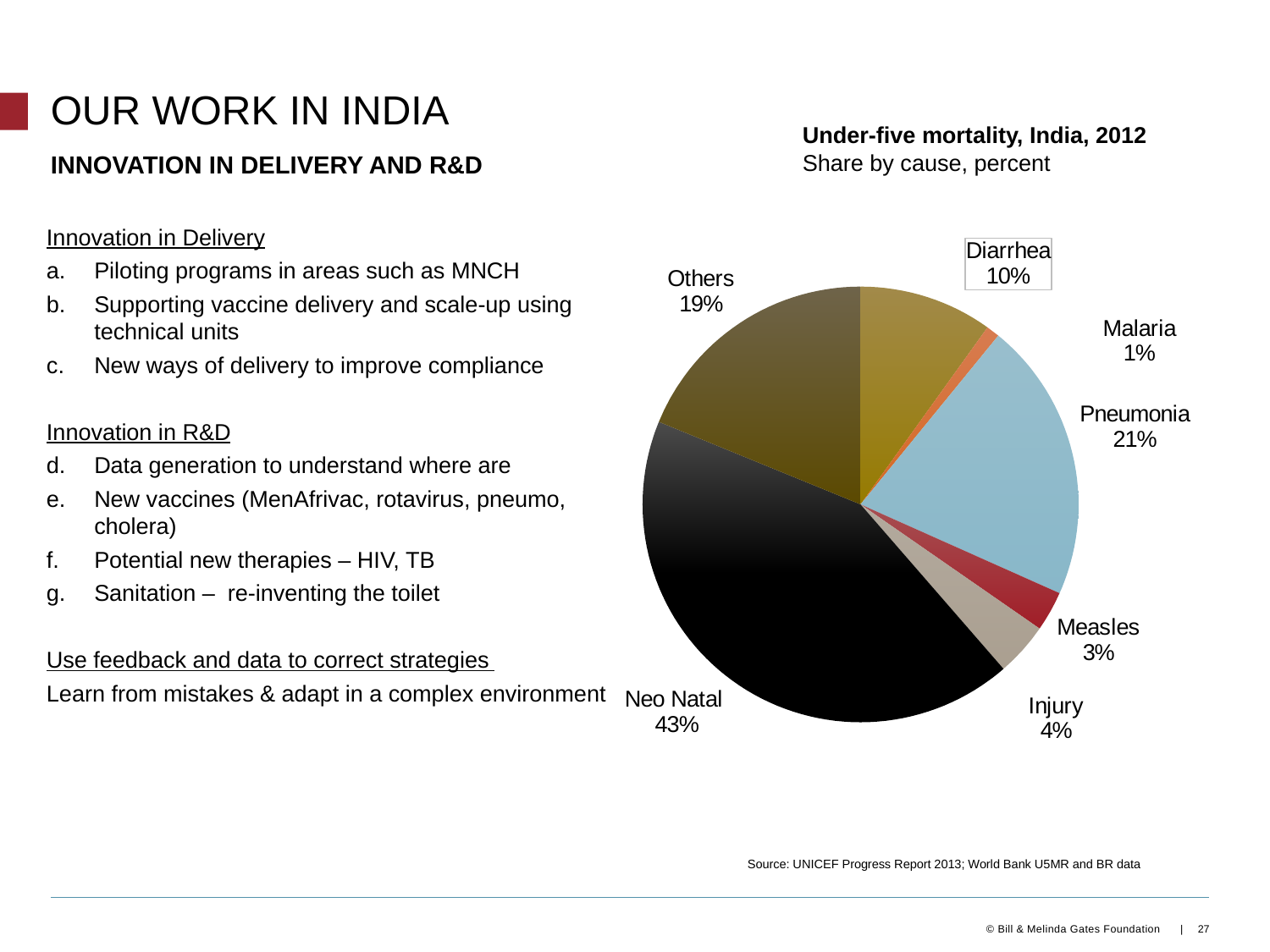
Which cause has the largest share of under-five mortality? Neo Natal What share of under-five mortality is attributed to Malaria? 1% What share of under-five mortality is attributed to Pneumonia? 21% What is the difference in percentage points between the Neo Natal share and the Pneumonia share? 22 What share of under-five mortality is attributed to Diarrhea? 10% Which cause has the smallest share of under-five mortality? Malaria What is the title of the chart? Under-five mortality, India, 2012 What kind of chart is shown on the slide? pie chart How many causes (slices) are shown in the pie chart? 7 What share of under-five mortality is attributed to Neo Natal causes? 43% Which has a larger share, Injury or Measles? Injury What is the combined share of Others and Diarrhea? 29%